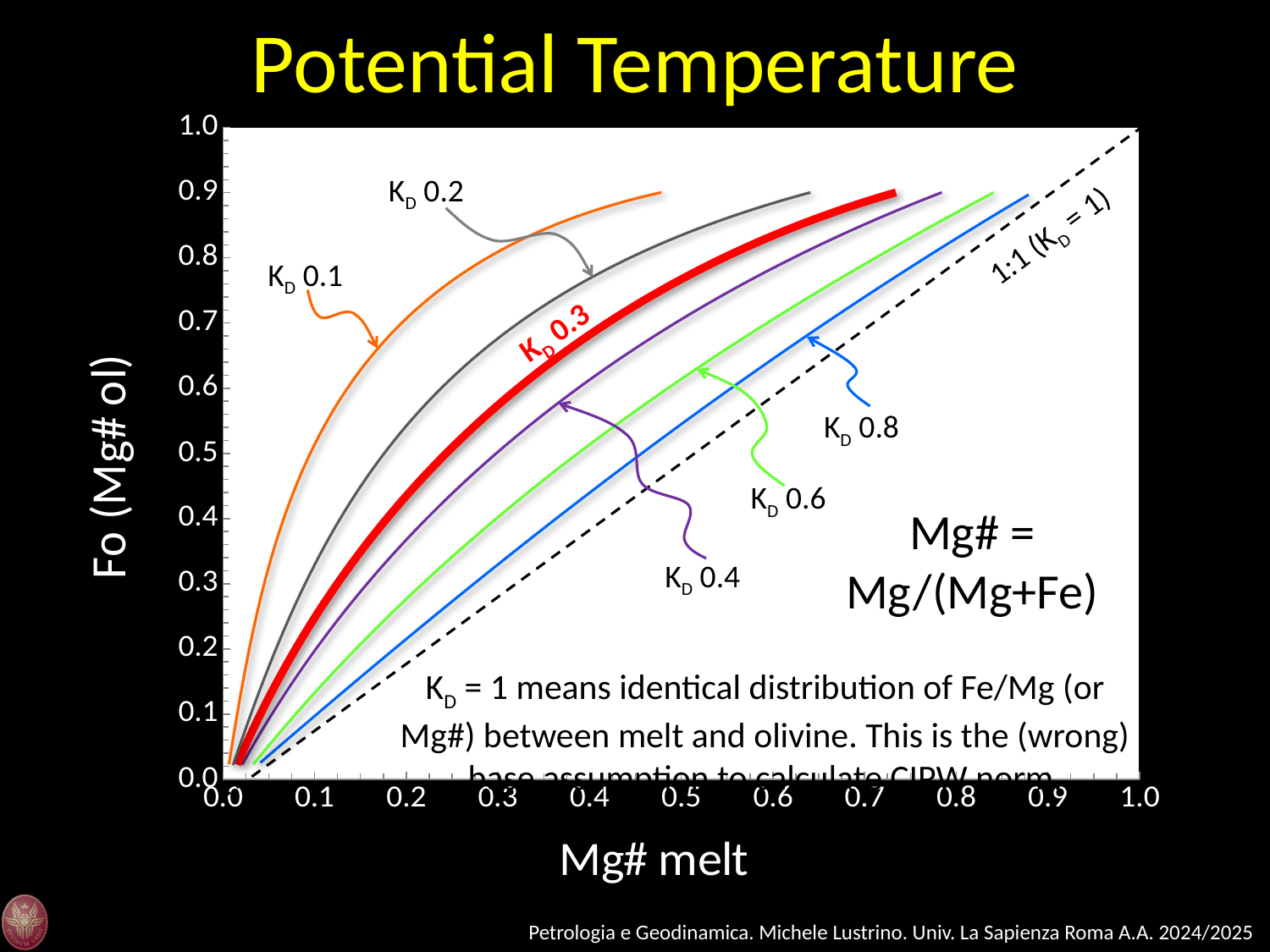
At Mg# melt 0.6, which curve has the higher Fo (Mg# ol): K_D 0.4 or K_D 0.8? K_D 0.4 How many labelled K_D curves (including the 1:1 line) are plotted on the chart? 7 Along the K_D 0.3 curve, does Fo (Mg# ol) rise or fall as Mg# melt increases? rise On the K_D 0.1 curve at Mg# melt 0.1, is Fo (Mg# ol) greater or less than 0.5? greater On the K_D 0.8 curve at Mg# melt 0.5, is Fo (Mg# ol) greater or less than 0.7? less At Mg# melt 0.4, which curve has the higher Fo (Mg# ol): K_D 0.2 or K_D 0.6? K_D 0.2 Which line lies lowest on the chart, giving the smallest Fo for a given Mg# melt? 1:1 (K_D = 1) Which curve lies highest on the chart, giving the largest Fo for a given Mg# melt? K_D 0.1 What kind of chart is shown on the slide? line chart Which curve on the chart is drawn as a dashed line? 1:1 (K_D = 1) What is the label of the x axis of the chart? Mg# melt On the K_D 0.3 curve at Mg# melt 0.3, is Fo (Mg# ol) greater or less than 0.5? greater